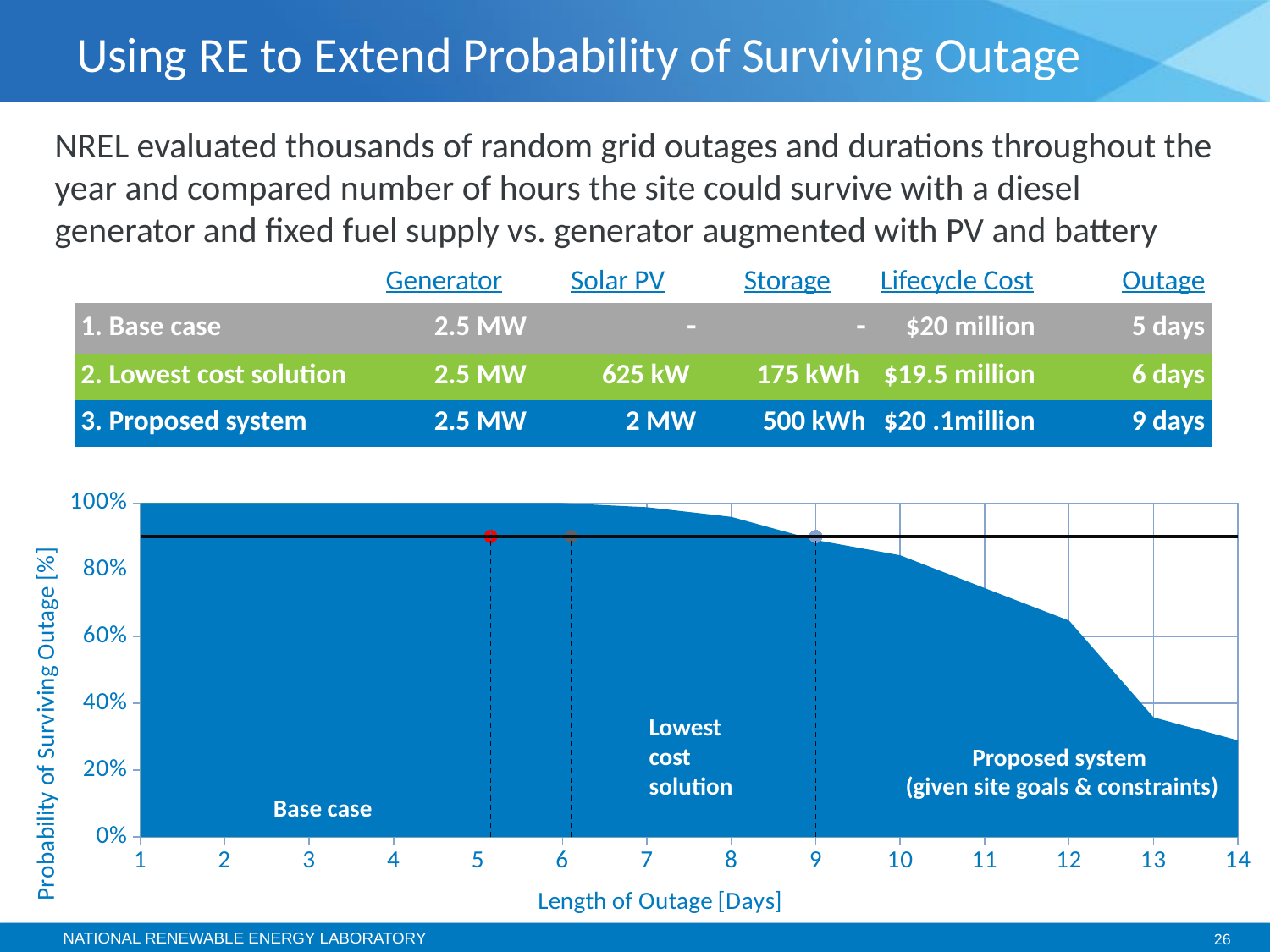
Is the probability of surviving an outage at 14 days greater or less than 40%? less Is the probability of surviving an outage at 10 days greater or less than 60%? greater How many day values are marked on the x axis of the chart? 14 Does the probability of surviving an outage rise or fall as the length of outage increases? fall Is the probability of surviving an outage at 12 days greater or less than 80%? less What is the label of the y axis of the chart? Probability of Surviving Outage [%] What is the label of the x axis of the chart? Length of Outage [Days] What kind of chart is shown on the slide? area chart Which is larger: the probability of surviving an outage at 3 days or at 13 days? 3 days